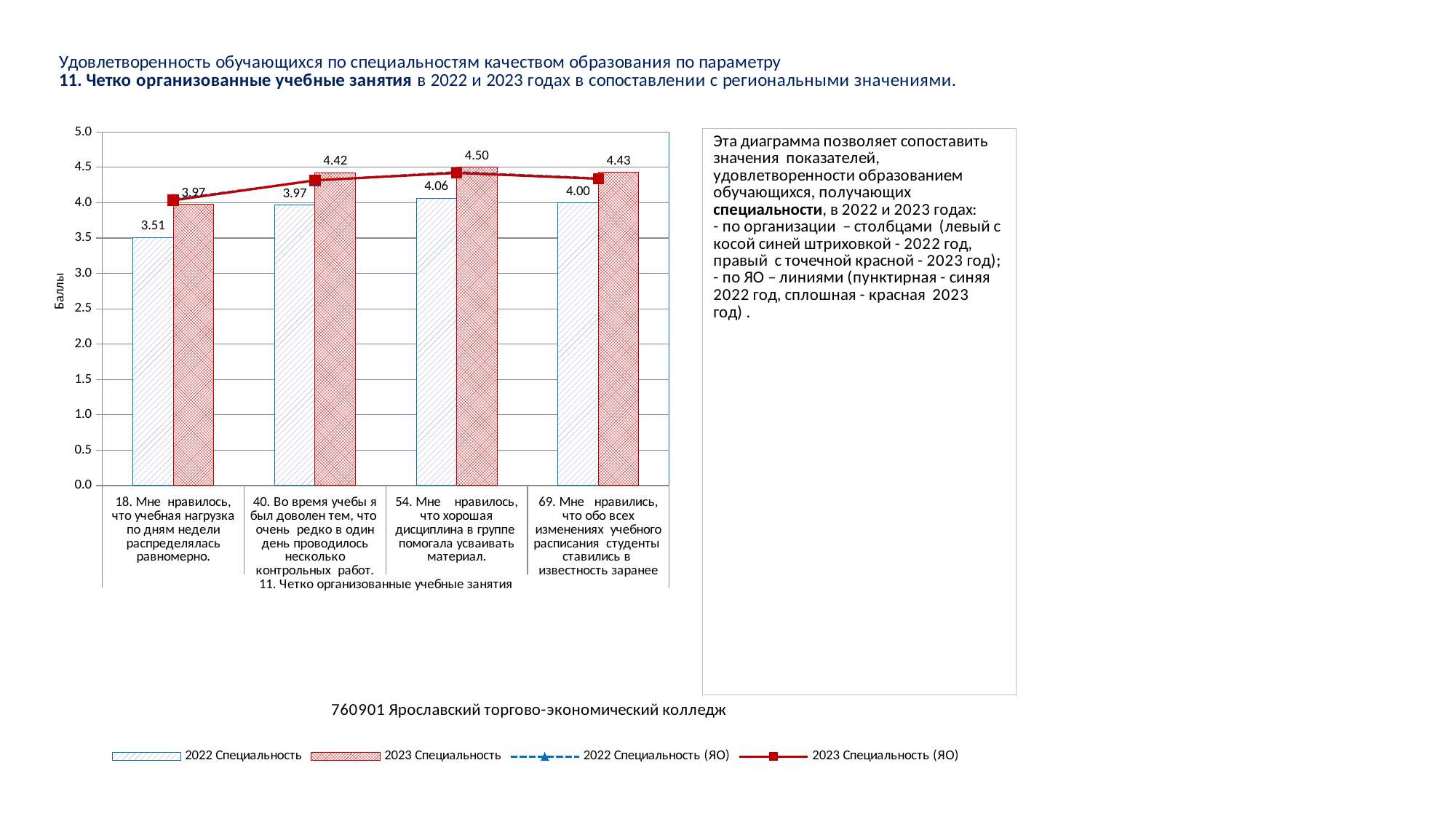
Which is larger: the 2022 Специальность value for question 54 or for question 69? Question 54 (4.06) How many series does the chart legend list? 4 Which question has the highest 2023 Специальность bar? 54. Мне нравилось, что хорошая дисциплина в группе помогала усваивать материал. What is the difference between the 2023 Специальность values for question 54 and question 18? 0.53 How many questions (categories) are shown on the x axis of the chart? 4 What is the value of the 2022 Специальность bar for question 40 (очень редко в один день проводилось несколько контрольных работ)? 3.97 Which question has the lowest 2022 Специальность bar? 18. Мне нравилось, что учебная нагрузка по дням недели распределялась равномерно. What is the value of the 2023 Специальность bar for question 69 (обо всех изменениях учебного расписания студенты ставились в известность заранее)? 4.43 By how much did the Специальность value for question 18 increase from 2022 to 2023? 0.46 What is the value of the 2022 Специальность bar for question 18 (Мне нравилось, что учебная нагрузка по дням недели распределялась равномерно)? 3.51 Is the 2023 Специальность (ЯО) line value for question 54 greater or less than 4.0? greater What is the value of the 2023 Специальность bar for question 54 (хорошая дисциплина в группе помогала усваивать материал)? 4.50